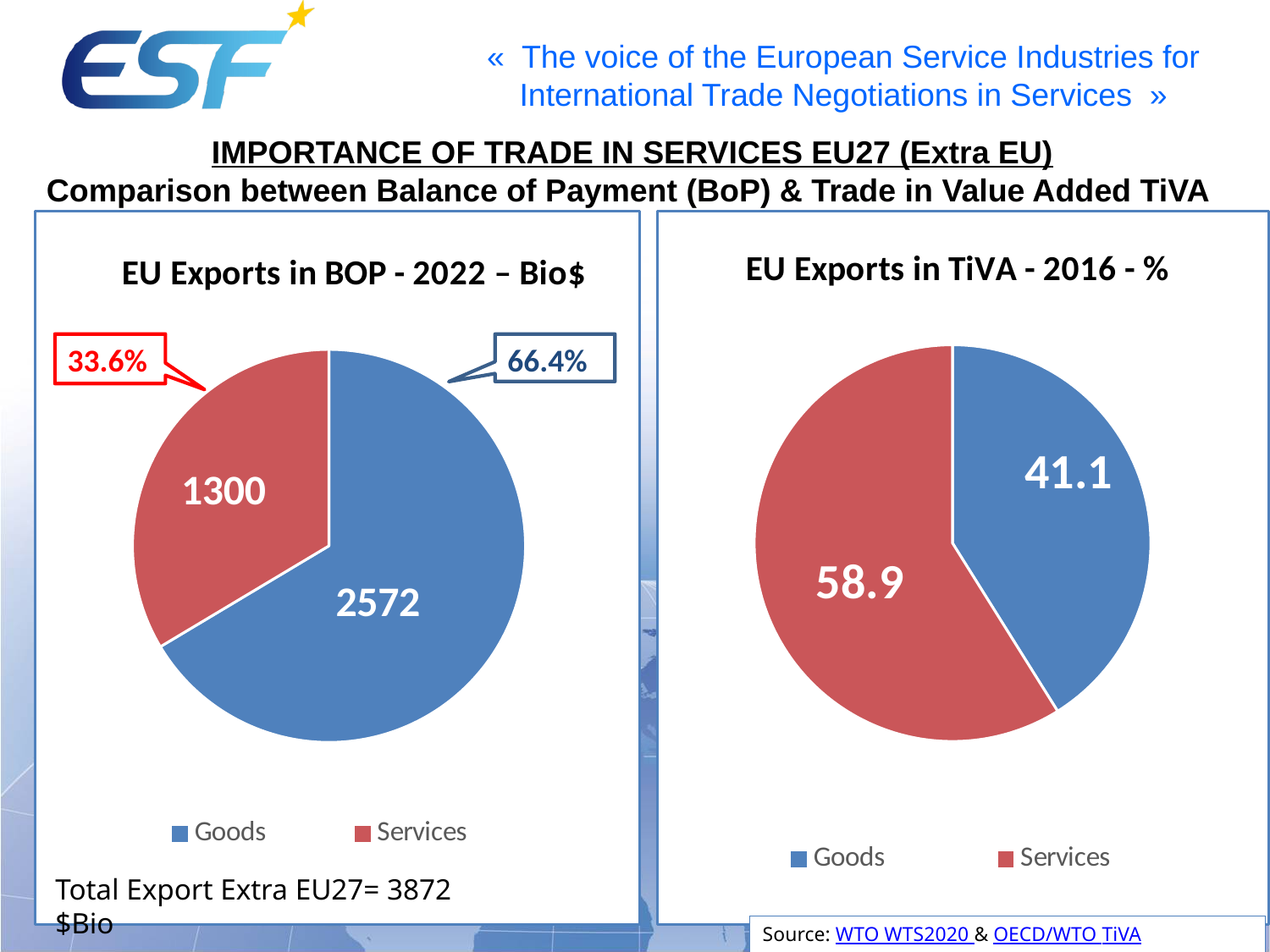
In the 'EU Exports in TiVA - 2016 - %' chart, what is the value for Services? 58.9 In the 'EU Exports in BOP - 2022 – Bio$' chart, what share of the pie does Services represent? 33.6% In the 'EU Exports in TiVA - 2016 - %' chart, which category has the smallest slice? Goods In the 'EU Exports in BOP - 2022 – Bio$' chart, what is the value for Goods? 2572 In the 'EU Exports in BOP - 2022 – Bio$' chart, what colour is the Services slice? Red In the 'EU Exports in BOP - 2022 – Bio$' chart, which category has the largest slice? Goods How many categories does the legend of the 'EU Exports in BOP - 2022 – Bio$' chart list? 2 In the 'EU Exports in BOP - 2022 – Bio$' chart, what is the value for Services? 1300 In the 'EU Exports in TiVA - 2016 - %' chart, which is larger, Goods or Services? Services In the 'EU Exports in BOP - 2022 – Bio$' chart, what is the difference between the Goods and Services values? 1272 What type of chart is 'EU Exports in TiVA - 2016 - %'? Pie chart In the 'EU Exports in TiVA - 2016 - %' chart, what is the value for Goods? 41.1